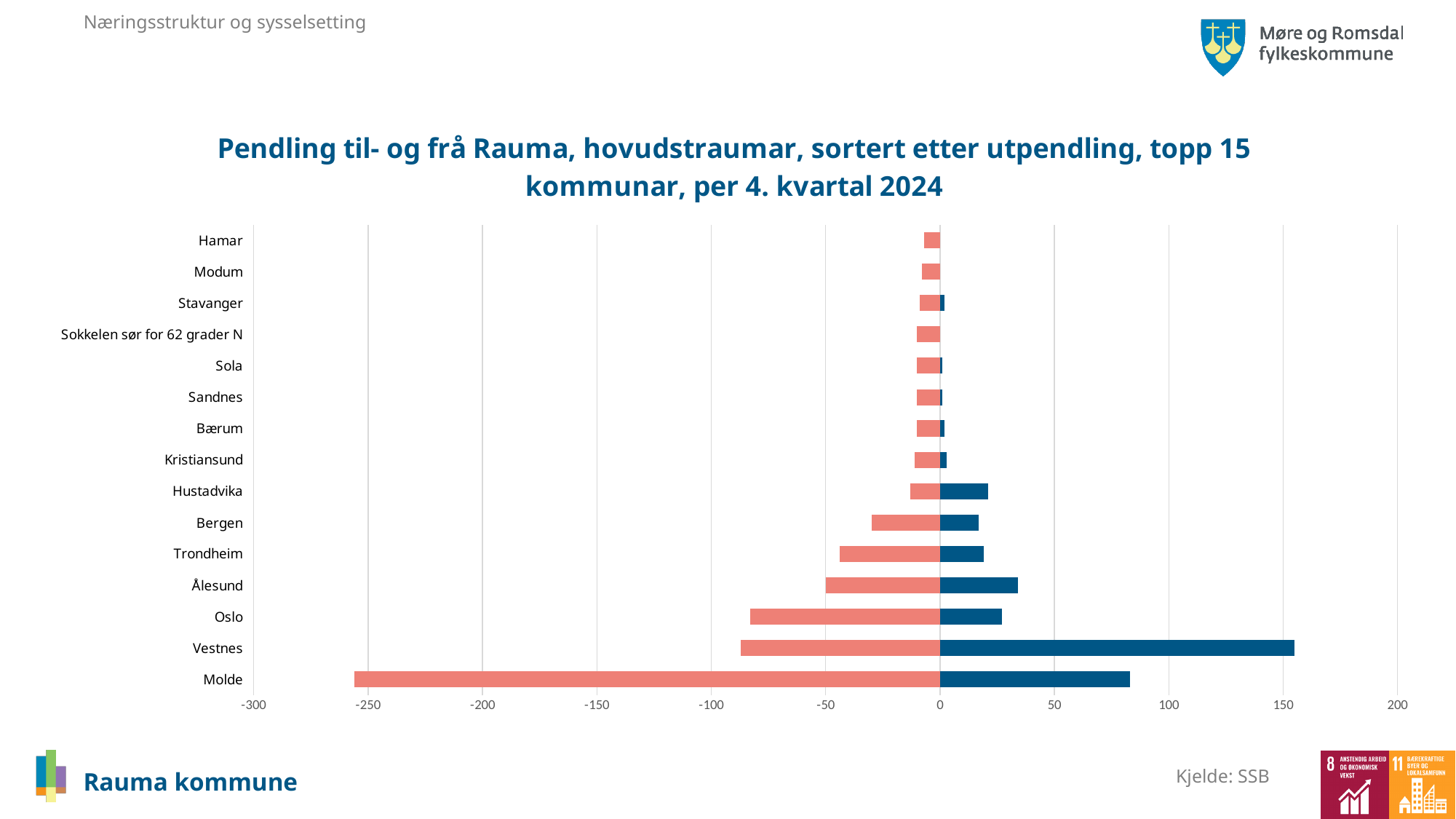
Is the blue bar value for Molde greater or less than 50? greater Which municipality has the longest red (negative) bar in the chart? Molde Which municipality has the longest blue (positive) bar in the chart? Vestnes Is the blue bar value for Hustadvika greater or less than 50? less Which has the larger blue (positive) bar, Molde or Vestnes? Vestnes How many municipalities (categories) are listed on the vertical axis of the chart? 15 What kind of chart is shown on the slide? bar chart Is the red bar value for Oslo greater or less than -50? less Which has the longer red (negative) bar, Bergen or Trondheim? Trondheim What is the title of the chart? Pendling til- og frå Rauma, hovudstraumar, sortert etter utpendling, topp 15 kommunar, per 4. kvartal 2024